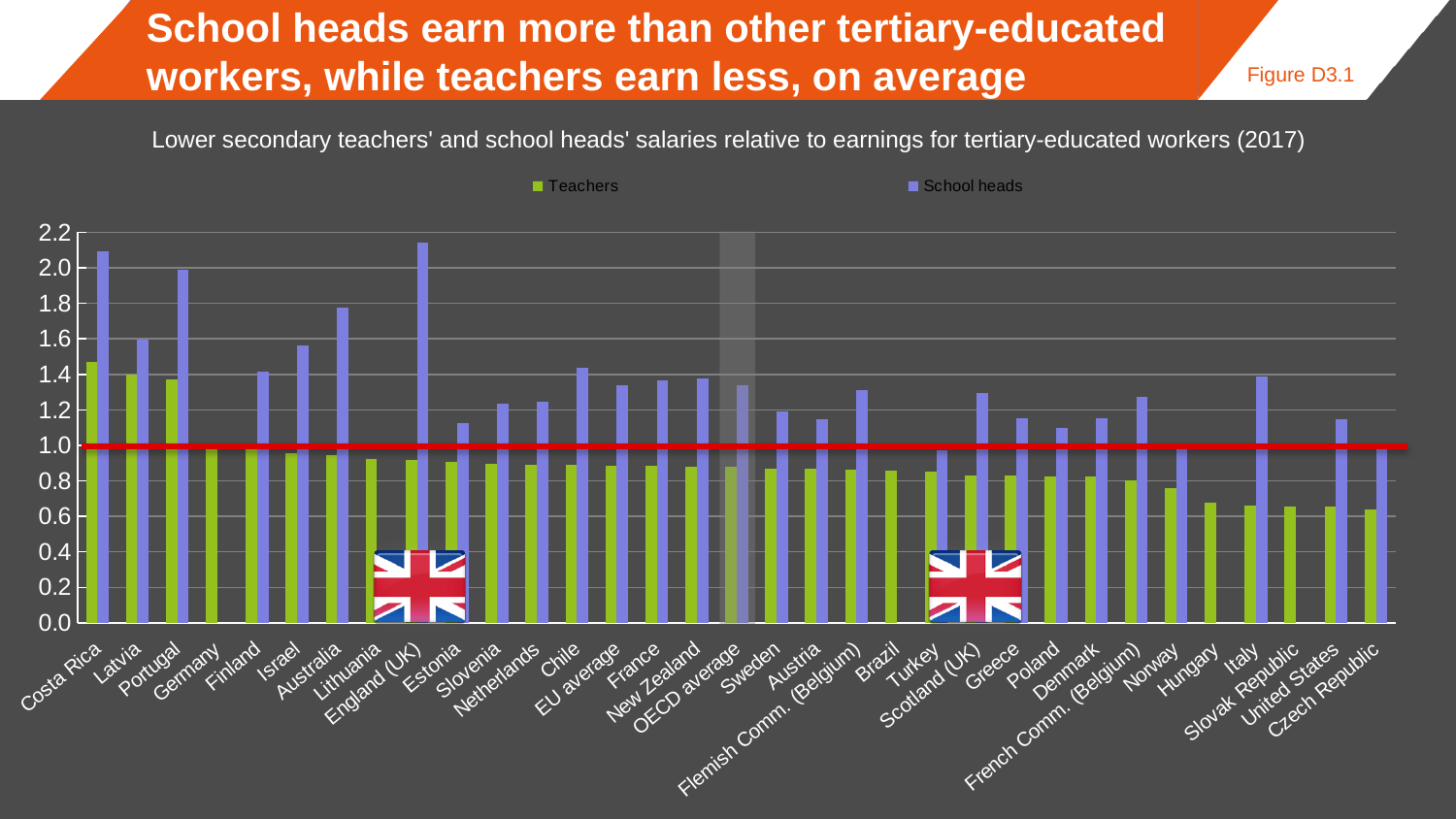
Which is larger, the Teachers value for Germany or the Teachers value for Hungary? Germany How many series does the legend list? 2 Do the Teachers values generally rise or fall from left to right along the x axis? fall Is the Teachers value for Hungary greater or less than 0.8? less Is the School heads value for Australia greater or less than 1.6? greater Which colour represents the Teachers series in the legend? green What kind of chart is shown on the slide? bar chart Which is larger, the School heads value for Costa Rica or the School heads value for Latvia? Costa Rica Is the Teachers value for Costa Rica greater or less than 1.2? greater How many countries or regions are shown on the x axis? 33